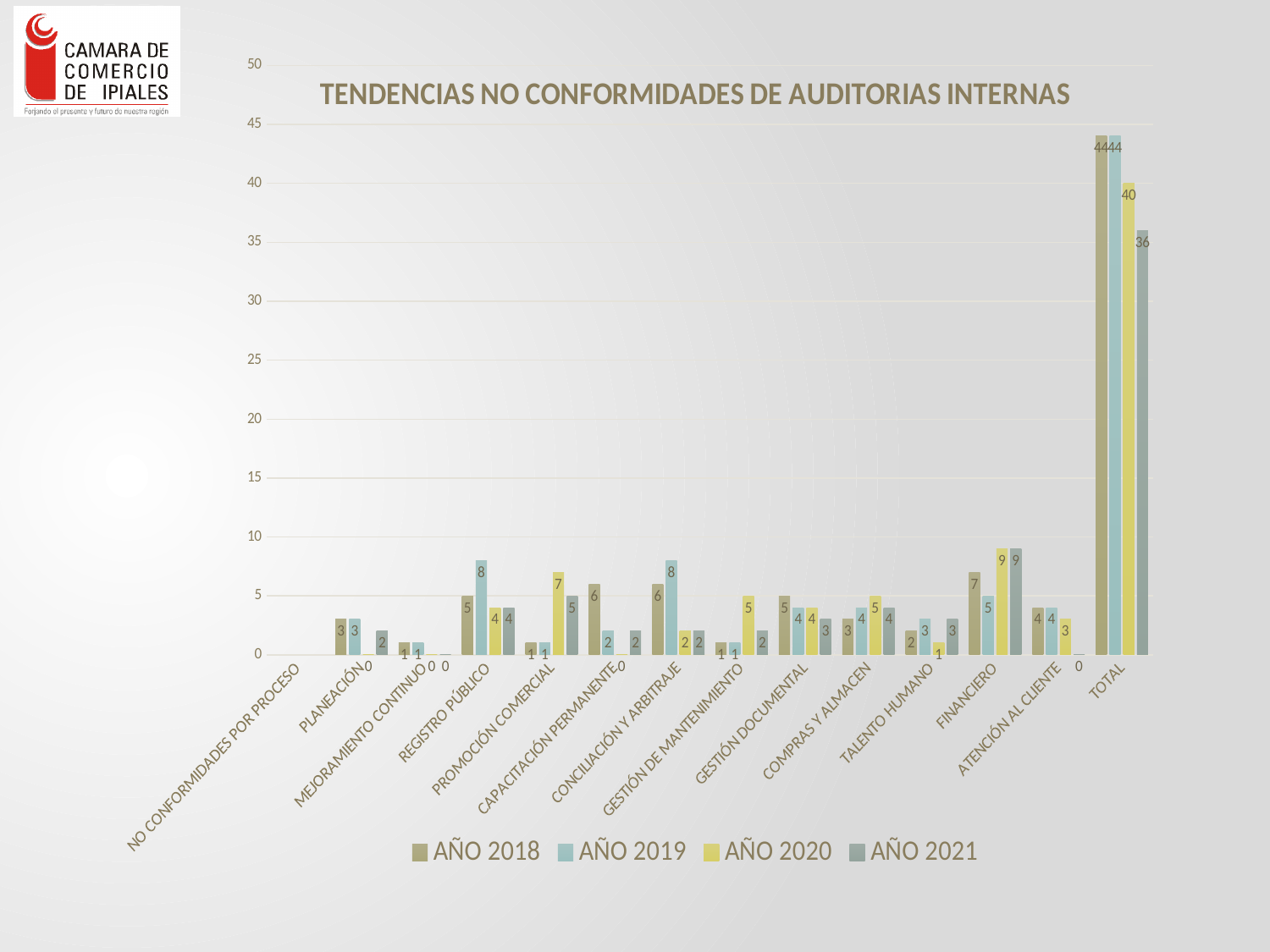
Excluding TOTAL, which category has the highest value in the AÑO 2021 series? FINANCIERO Is the TOTAL value for AÑO 2019 greater or less than 40? greater What is the difference between the TOTAL values for AÑO 2018 and AÑO 2021? 8 How many series does the legend list? 4 What is the value for FINANCIERO in the AÑO 2018 series? 7 Do the TOTAL values rise or fall from AÑO 2018 to AÑO 2021? fall What is the value for TOTAL in the AÑO 2020 series? 40 What kind of chart is shown on the slide? bar chart What is the value for PROMOCIÓN COMERCIAL in the AÑO 2020 series? 7 Which is larger: CONCILIACIÓN Y ARBITRAJE in AÑO 2019 or PROMOCIÓN COMERCIAL in AÑO 2020? CONCILIACIÓN Y ARBITRAJE in AÑO 2019 What is the value for REGISTRO PÚBLICO in the AÑO 2019 series? 8 Which year series has the lowest TOTAL value? AÑO 2021